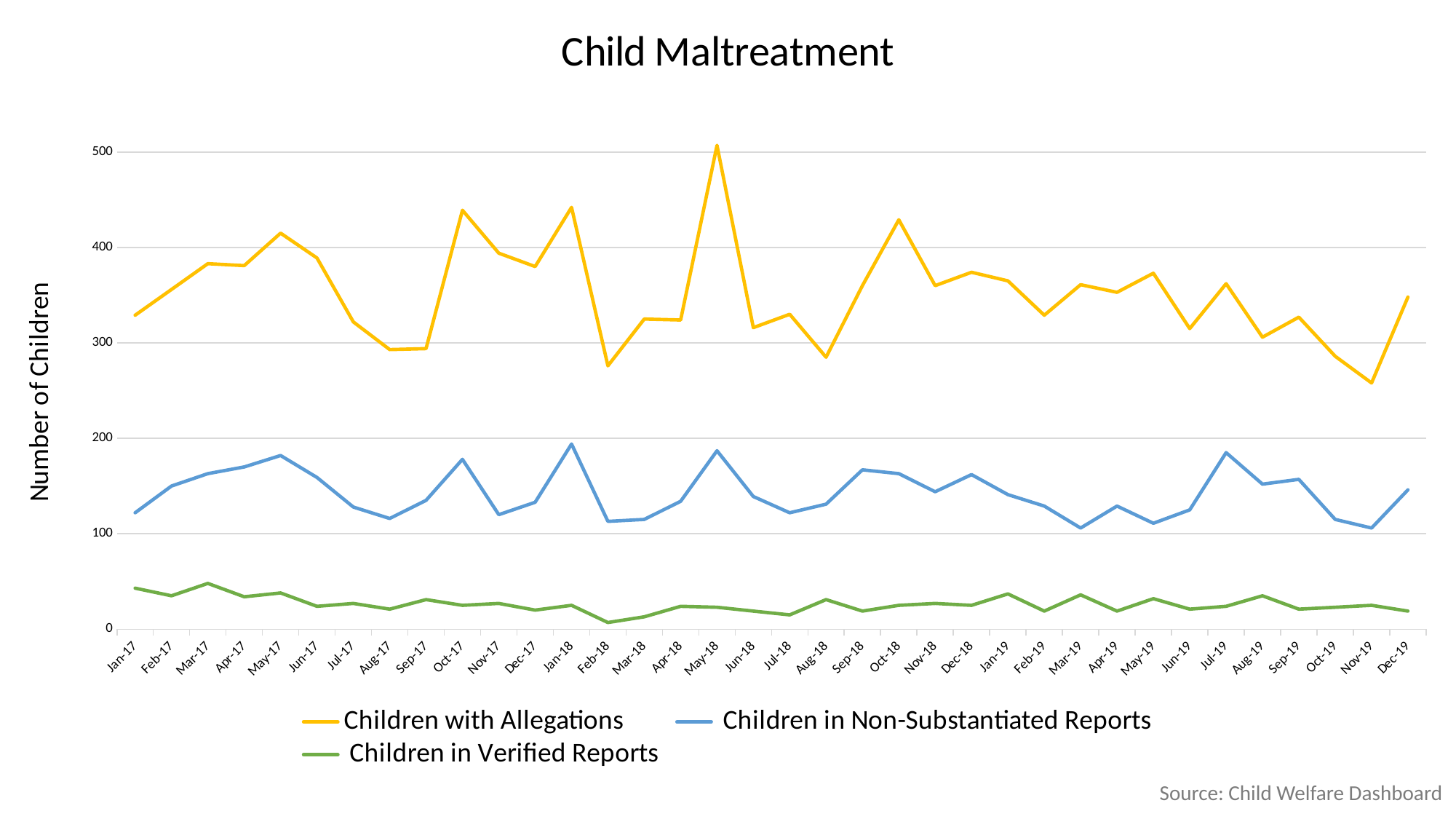
What is the title of the chart? Child Maltreatment In which month does the Children with Allegations series reach its highest value? May-18 How many months are plotted along the x axis? 36 How many series does the legend list? 3 Is the value for Children in Non-Substantiated Reports in Jan-18 greater or less than 200? less What is the label on the y axis? Number of Children In which month does the Children in Verified Reports series reach its lowest value? Feb-18 Which series is larger in Dec-19: Children with Allegations or Children in Non-Substantiated Reports? Children with Allegations Is the value for Children with Allegations in May-18 greater or less than 400? greater Is the value for Children with Allegations in Nov-19 greater or less than 300? less What kind of chart is shown on the slide? Line chart In which month does the Children in Verified Reports series reach its highest value? Mar-17